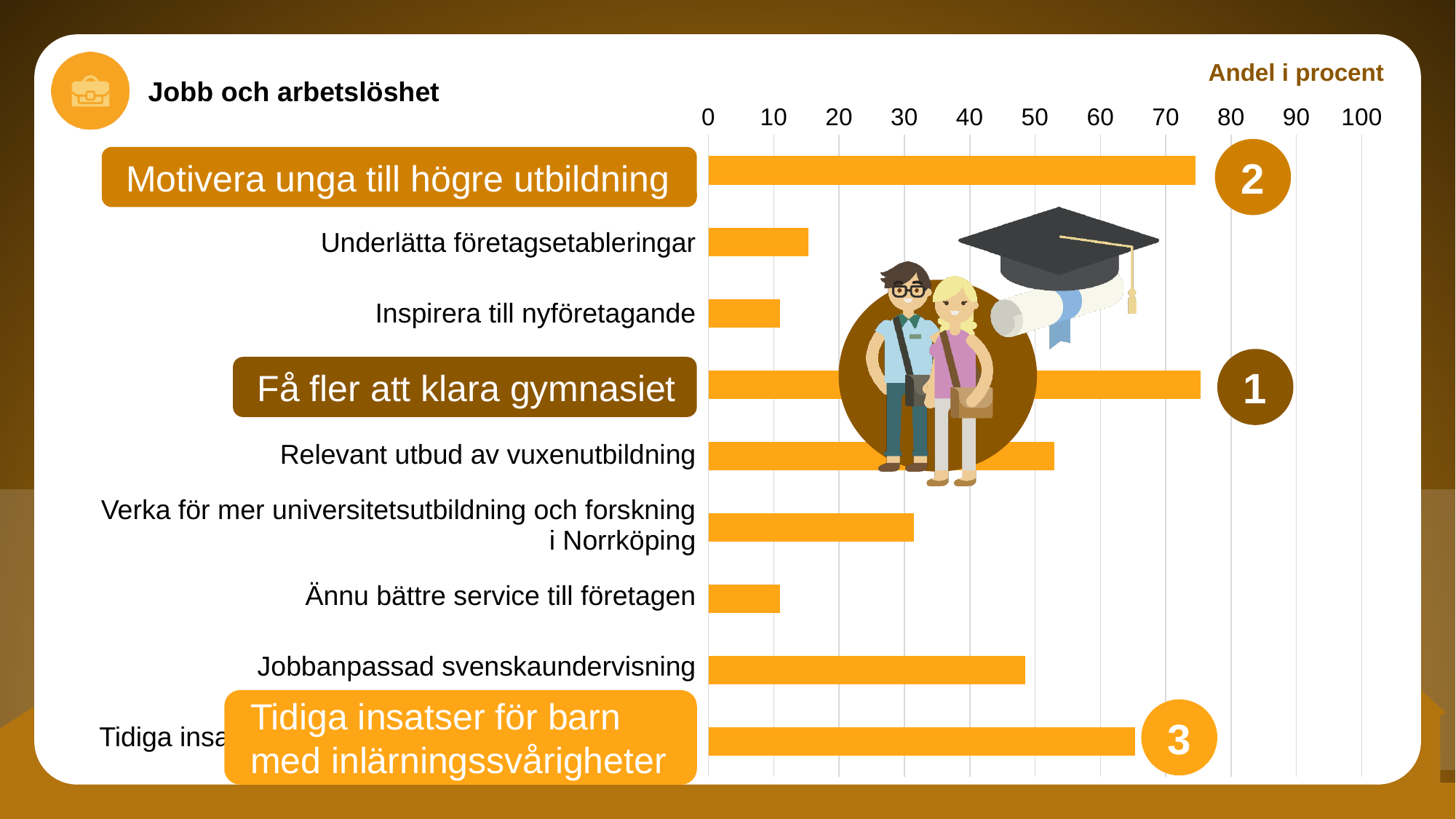
What is the label shown above the horizontal axis of the chart? Andel i procent What is the heading shown at the top left of the slide next to the briefcase icon? Jobb och arbetslöshet Which has the larger value: "Underlätta företagsetableringar" or "Jobbanpassad svenskaundervisning"? Jobbanpassad svenskaundervisning How many categories (bars) does the chart show? 9 Is the value for "Jobbanpassad svenskaundervisning" greater or less than 60? less Is the value for "Underlätta företagsetableringar" greater or less than 20? less Is the value for "Relevant utbud av vuxenutbildning" greater or less than 50? greater What kind of chart is shown on the slide? bar chart Which has the larger value: "Relevant utbud av vuxenutbildning" or "Verka för mer universitetsutbildning och forskning i Norrköping"? Relevant utbud av vuxenutbildning